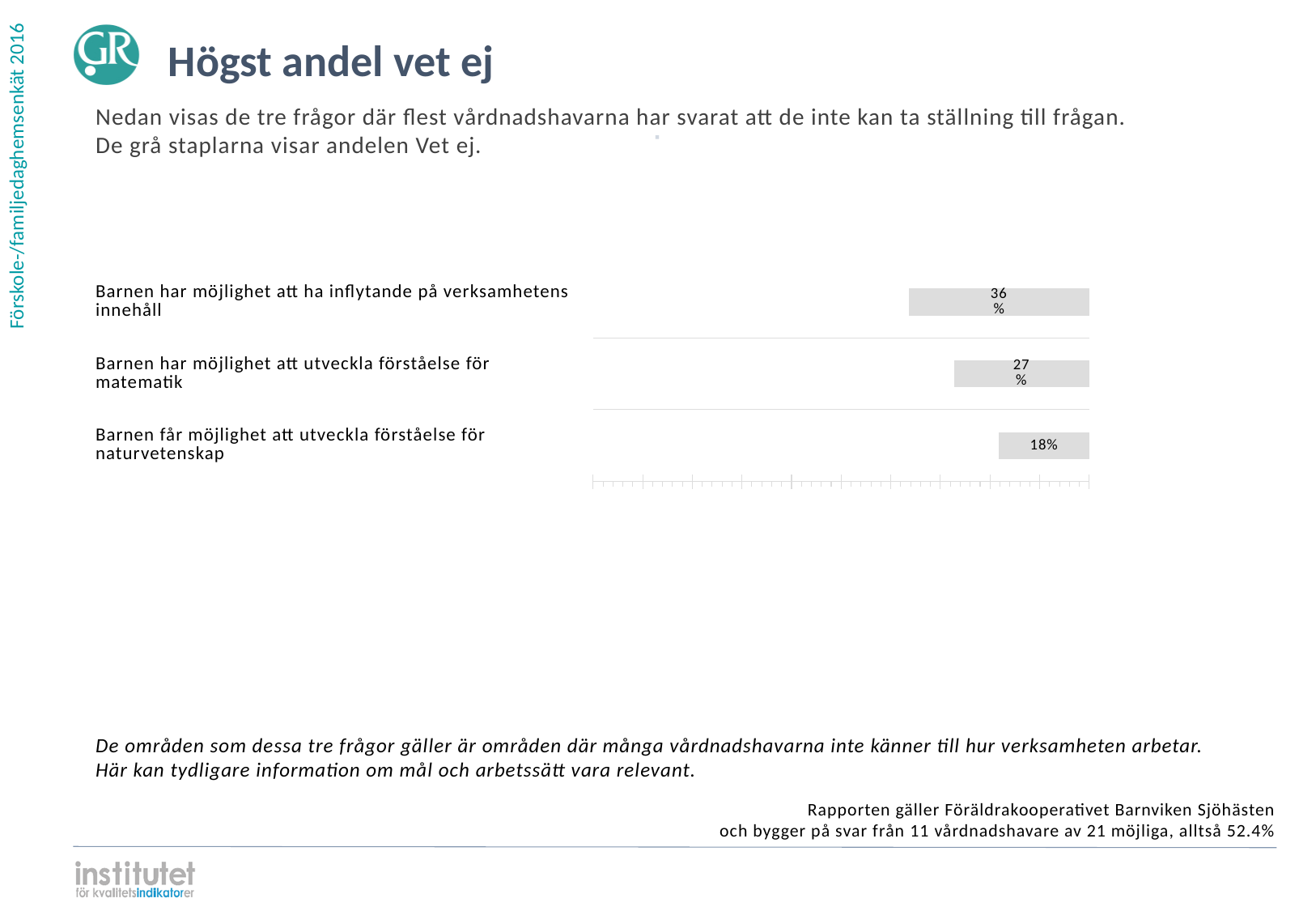
Which question has the lowest share of 'Vet ej' answers? Barnen får möjlighet att utveckla förståelse för naturvetenskap What kind of chart is shown on the slide? Bar chart How many questions are shown in the chart? 3 Which question has the highest share of 'Vet ej' answers? Barnen har möjlighet att ha inflytande på verksamhetens innehåll What is the 'Vet ej' share for 'Barnen har möjlighet att ha inflytande på verksamhetens innehåll'? 36% What is the 'Vet ej' share for 'Barnen har möjlighet att utveckla förståelse för matematik'? 27% Which has a larger 'Vet ej' share: the question about matematik or the question about naturvetenskap? The question about matematik What is the title of the slide? Högst andel vet ej What is the difference in percentage points between the 'Vet ej' share for the question about matematik and the question about naturvetenskap? 9 percentage points What is the 'Vet ej' share for 'Barnen får möjlighet att utveckla förståelse för naturvetenskap'? 18% What is the difference in percentage points between the 'Vet ej' share for the question about inflytande på verksamhetens innehåll and the question about naturvetenskap? 18 percentage points What colour are the bars in the chart? Grey